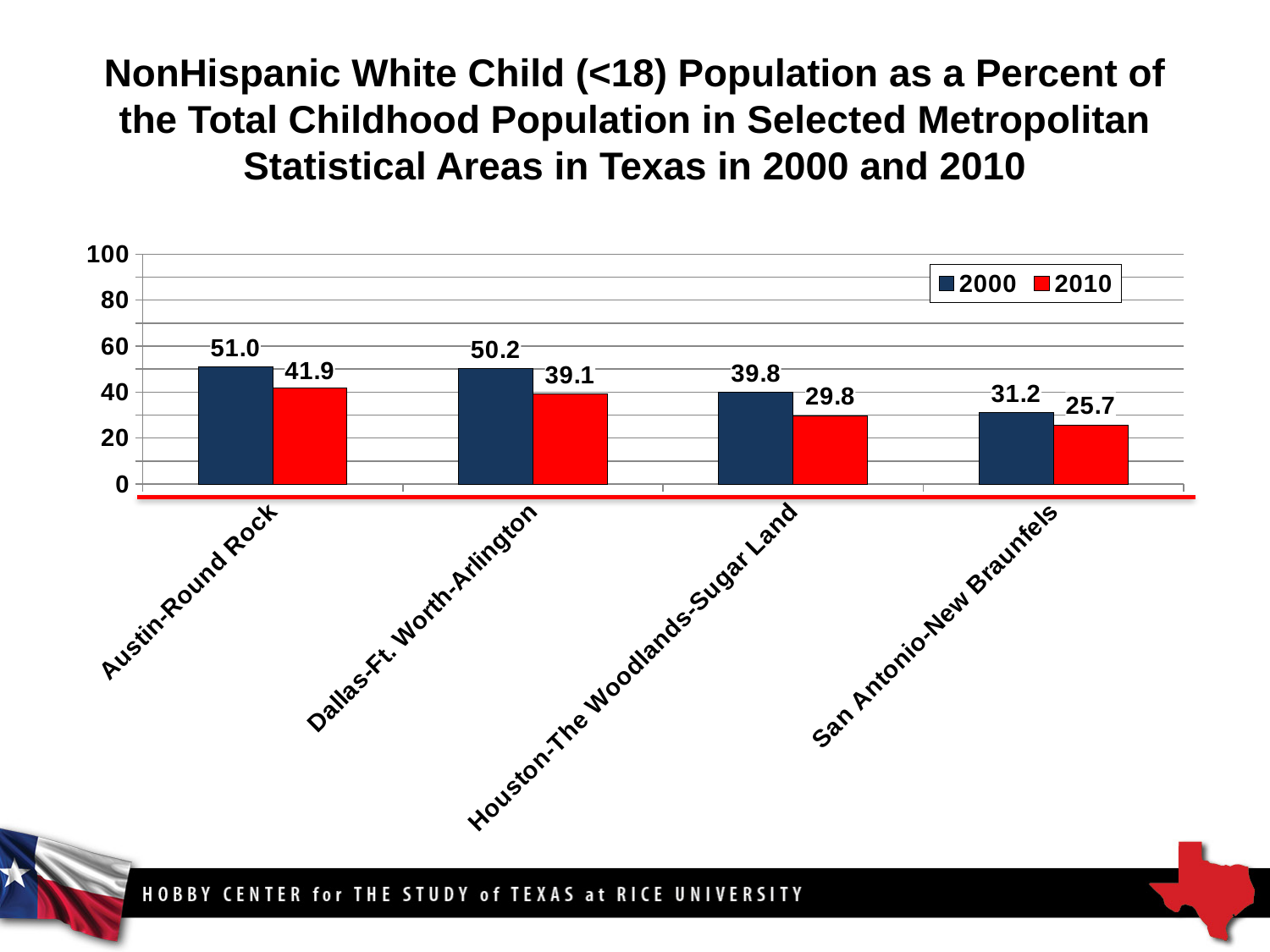
Which is larger: the 2010 value for Austin-Round Rock or the 2000 value for Houston-The Woodlands-Sugar Land? 2010 value for Austin-Round Rock What is the 2010 value for Houston-The Woodlands-Sugar Land? 29.8 What kind of chart is shown on the slide? bar chart What is the 2010 value for San Antonio-New Braunfels? 25.7 Which metropolitan area has the highest 2000 value? Austin-Round Rock Is the 2000 value for San Antonio-New Braunfels greater or less than 40? less Which metropolitan area has the lowest 2010 value? San Antonio-New Braunfels Which colour represents the 2010 series in the legend? red What is the difference between the 2000 and 2010 values for Dallas-Ft. Worth-Arlington? 11.1 How many metropolitan areas are shown on the chart? 4 How many series does the legend list? 2 What is the 2000 value for Austin-Round Rock? 51.0